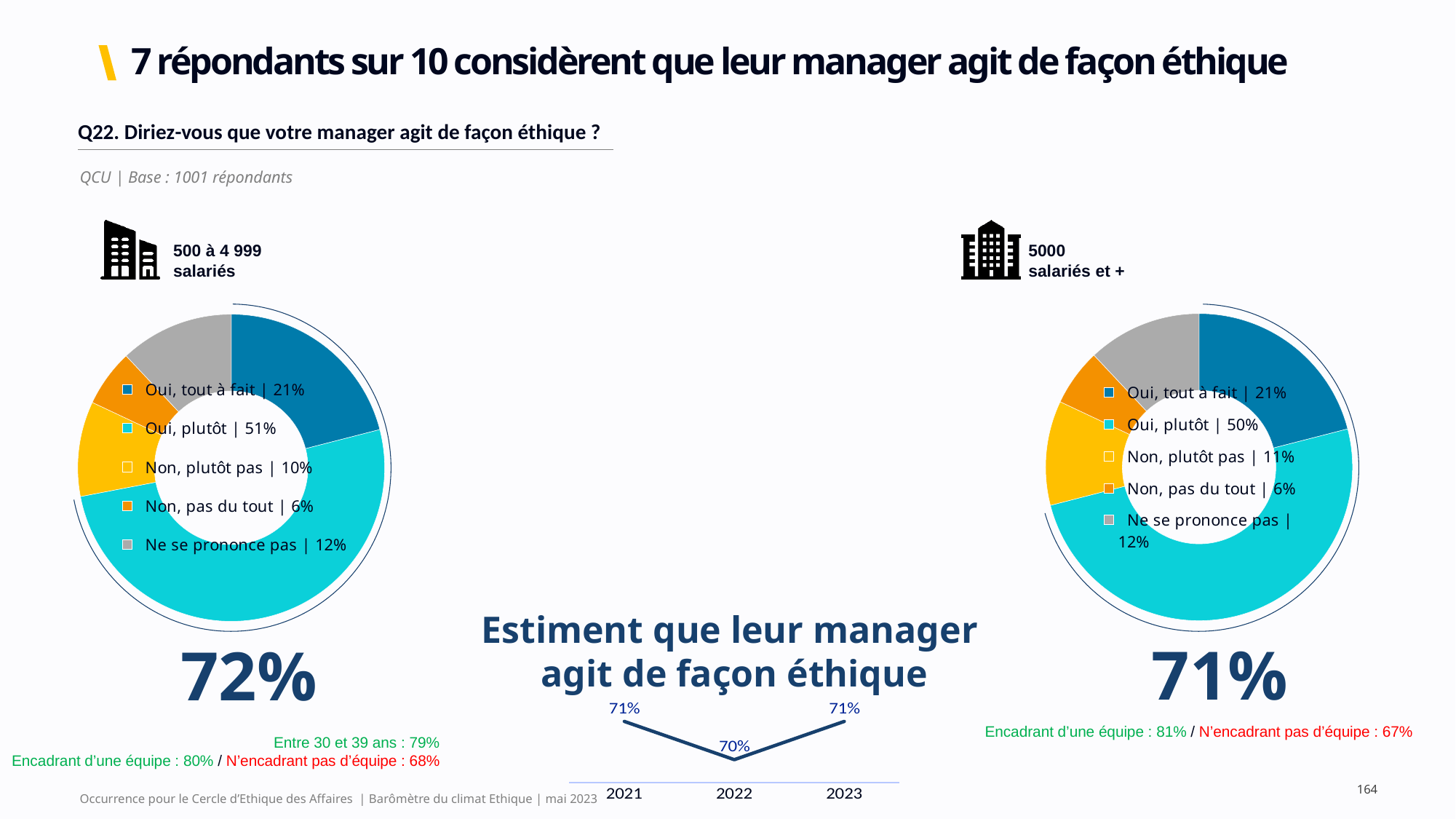
What kind of chart is used for the '5000 salariés et +' breakdown? Donut (pie) chart In the donut chart for '5000 salariés et +', which category has the smallest share? Non, pas du tout In the donut chart for '5000 salariés et +', what is the value for 'Non, plutôt pas'? 11% In the donut chart for '500 à 4 999 salariés', what colour represents 'Ne se prononce pas'? Grey In the donut chart for '500 à 4 999 salariés', what is the difference between 'Oui, plutôt' and 'Oui, tout à fait'? 30 percentage points How many data points are plotted in the line chart 'Estiment que leur manager agit de façon éthique'? 3 In the donut chart for '500 à 4 999 salariés', which category has the largest share? Oui, plutôt In the line chart 'Estiment que leur manager agit de façon éthique', what is the value for 2022? 70% In the line chart 'Estiment que leur manager agit de façon éthique', how does the value change from 2021 to 2022? It falls from 71% to 70% In the donut chart for '500 à 4 999 salariés', what is the value for 'Oui, plutôt'? 51% In the donut chart for '5000 salariés et +', which is larger: 'Ne se prononce pas' or 'Non, plutôt pas'? Ne se prononce pas How many categories does the legend of the donut chart for '500 à 4 999 salariés' list? 5